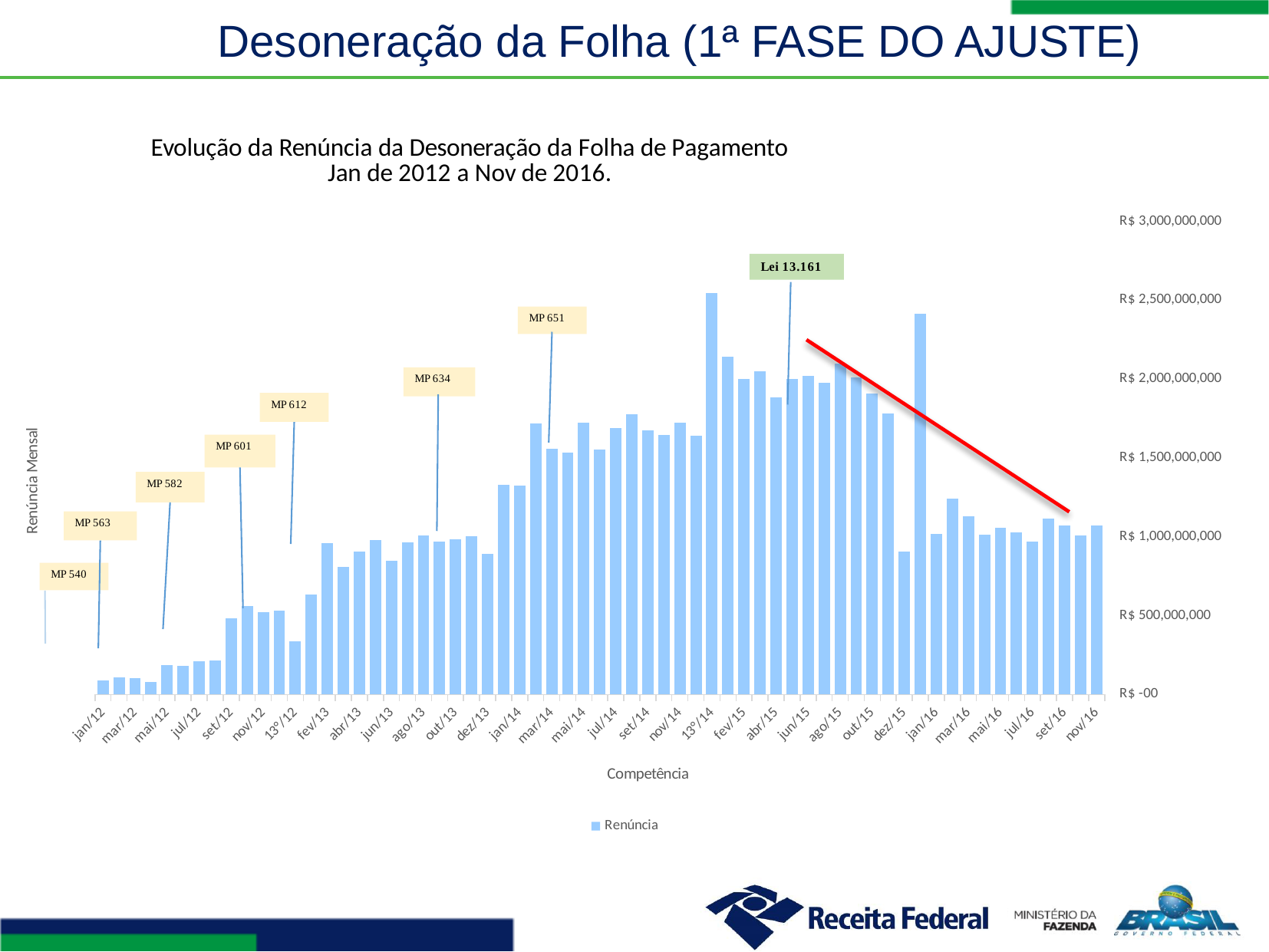
What type of chart is shown on the slide? bar chart Is the value for jan/12 greater or less than R$ 500,000,000? less Is the value for jul/14 greater or less than R$ 1,500,000,000? greater What is the title of the x axis? Competência Do the values generally rise or fall from jan/12 to jan/14? rise What is the name of the series shown in the legend? Renúncia Is the value for jan/14 greater or less than R$ 1,500,000,000? less How many series does the legend list? 1 Which month has the highest value in the chart? 13°/14 Which is larger, the value for jan/16 or the value for mar/16? mar/16